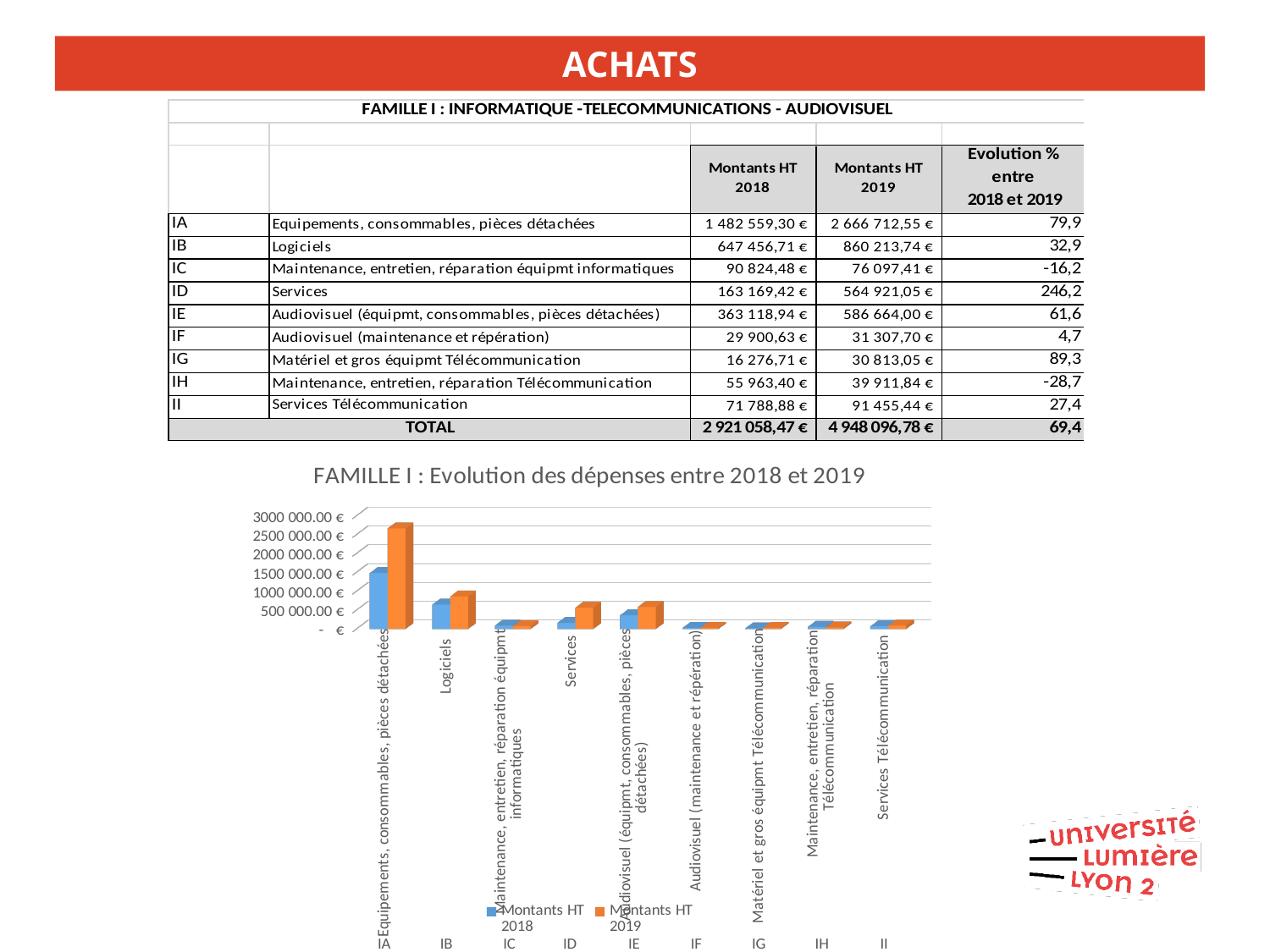
How many categories are plotted along the x axis of the chart? 9 How many series does the legend of the chart list? 2 Which category has the tallest Montants HT 2019 bar in the chart? IA (Equipements, consommables, pièces détachées) Is the Montants HT 2018 value for IA (Equipements, consommables, pièces détachées) greater or less than 1 000 000 €? greater Is the Montants HT 2019 value for IA (Equipements, consommables, pièces détachées) greater or less than 2 500 000 €? greater What is the Montants HT 2019 value for Logiciels? 860 213,74 € What kind of chart is shown under the title 'FAMILLE I : Evolution des dépenses entre 2018 et 2019'? Bar chart What are the two legend entries of the chart? Montants HT 2018 and Montants HT 2019 What is the difference between the Montants HT 2019 and Montants HT 2018 values for Equipements, consommables, pièces détachées? 1 184 153,25 € Which has the larger Montants HT 2019 value, IB (Logiciels) or ID (Services)? IB (Logiciels) Is the Montants HT 2019 value for IB (Logiciels) greater or less than 1 000 000 €? less What is the Montants HT 2018 value for Maintenance, entretien, réparation équipmt informatiques? 90 824,48 €